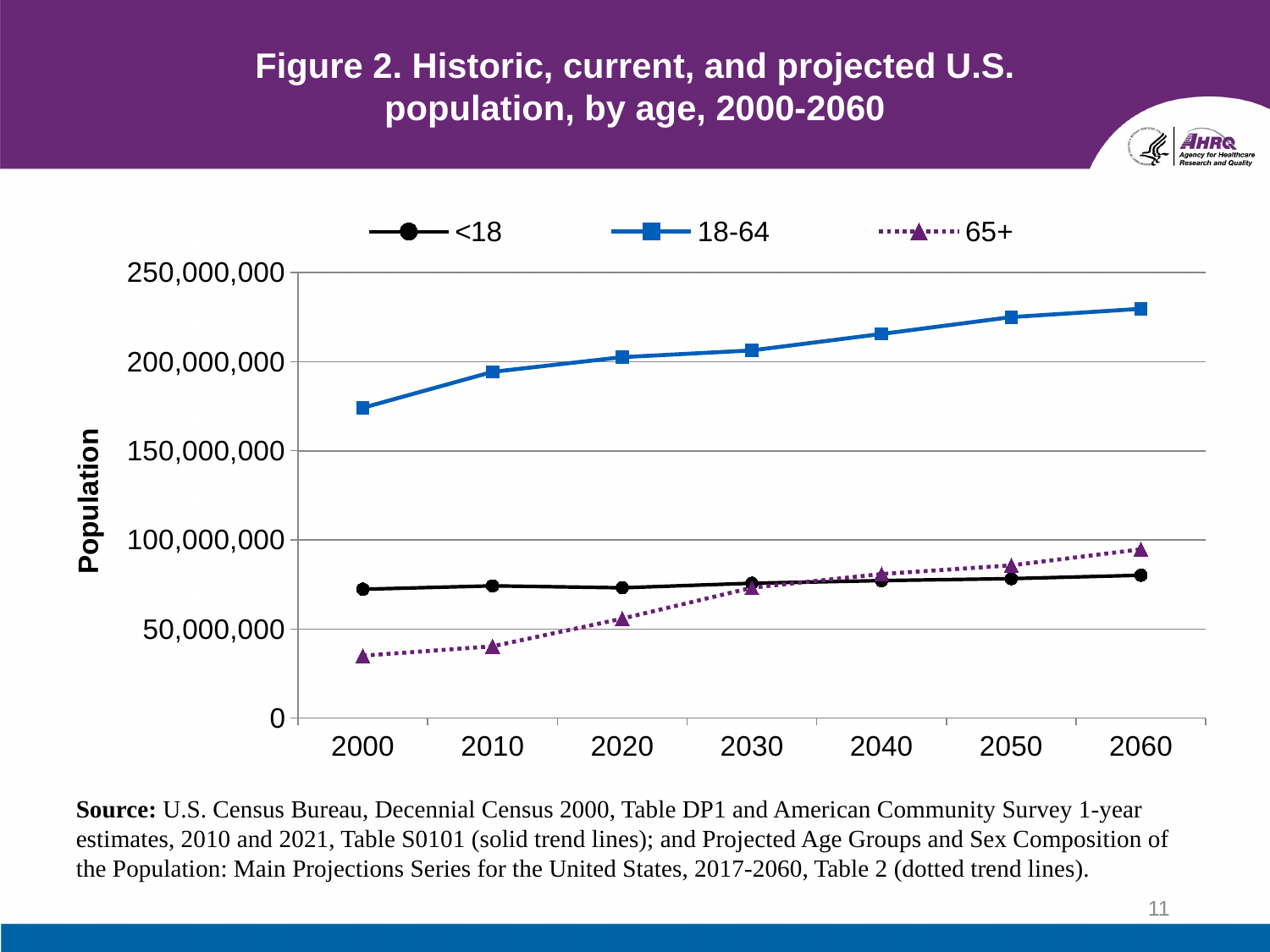
Is the value for the 65+ group in 2000 greater or less than 50,000,000? less What is the label on the vertical axis? Population Which age group has the lowest population in 2000? 65+ Which age group has the highest population in 2060? 18-64 Does the population of the 65+ group rise or fall from 2000 to 2060? rise What kind of chart is shown on the slide? line chart Is the value for the 18-64 group in 2060 greater or less than 200,000,000? greater In 2060, which is larger: the population of the 65+ group or the <18 group? 65+ How many years are plotted along the x axis? 7 How many series does the legend list? 3 Is the value for the 18-64 group in 2000 greater or less than 150,000,000? greater